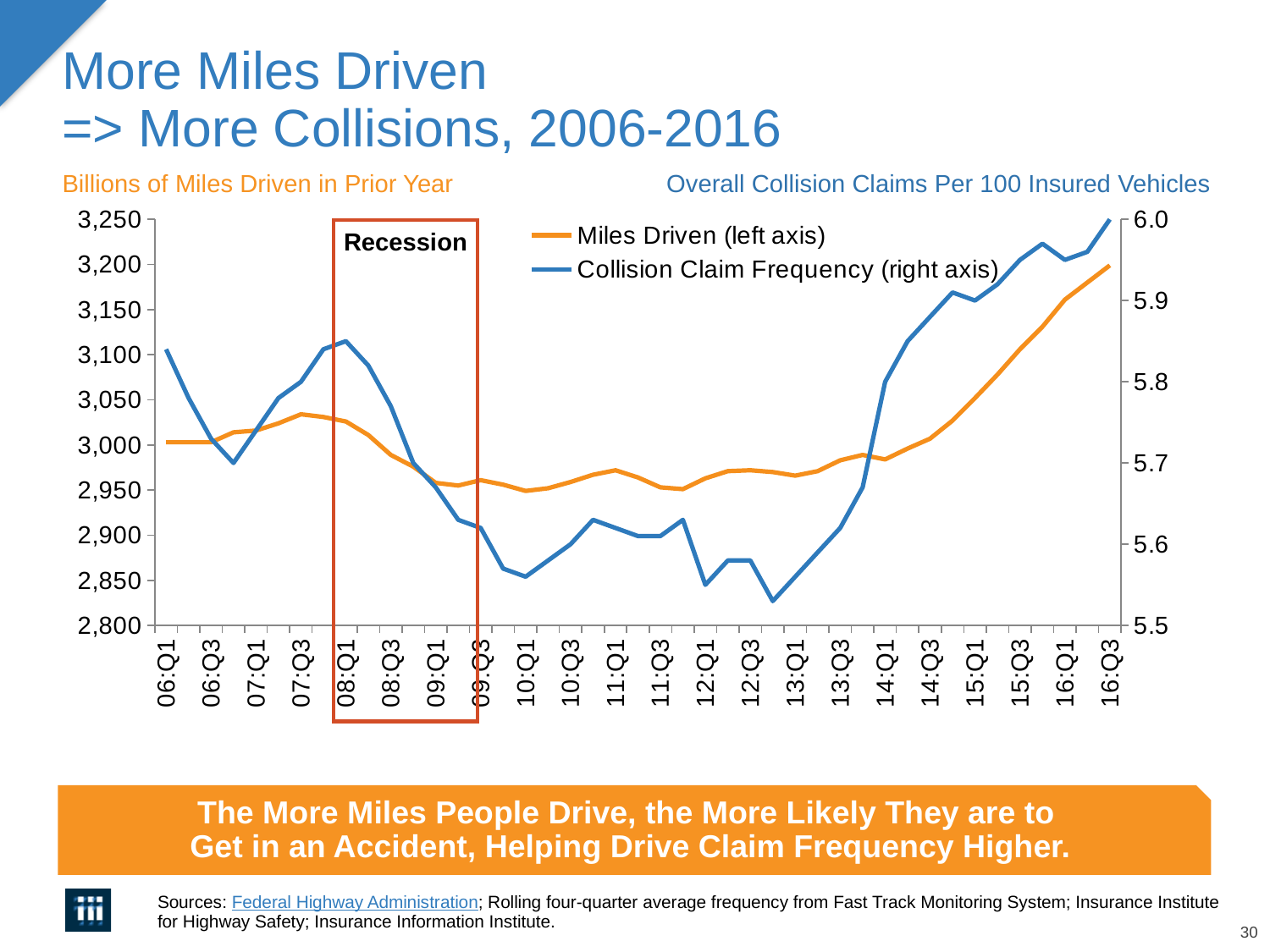
How many quarter labels are printed along the x axis? 22 What is the label of the left vertical axis? Billions of Miles Driven in Prior Year Is the value for Miles Driven at 16:Q3 greater or less than 3,150? greater How many series does the legend list? 2 Is the value for Collision Claim Frequency at 12:Q1 greater or less than 5.6? less Does Miles Driven rise or fall from 14:Q1 to 16:Q3? rise Is the value for Miles Driven at 10:Q1 greater or less than 3,000? less At which quarter does Miles Driven reach its highest value? 16:Q3 What kind of chart is shown on the slide? line chart Which series is plotted against the right axis? Collision Claim Frequency